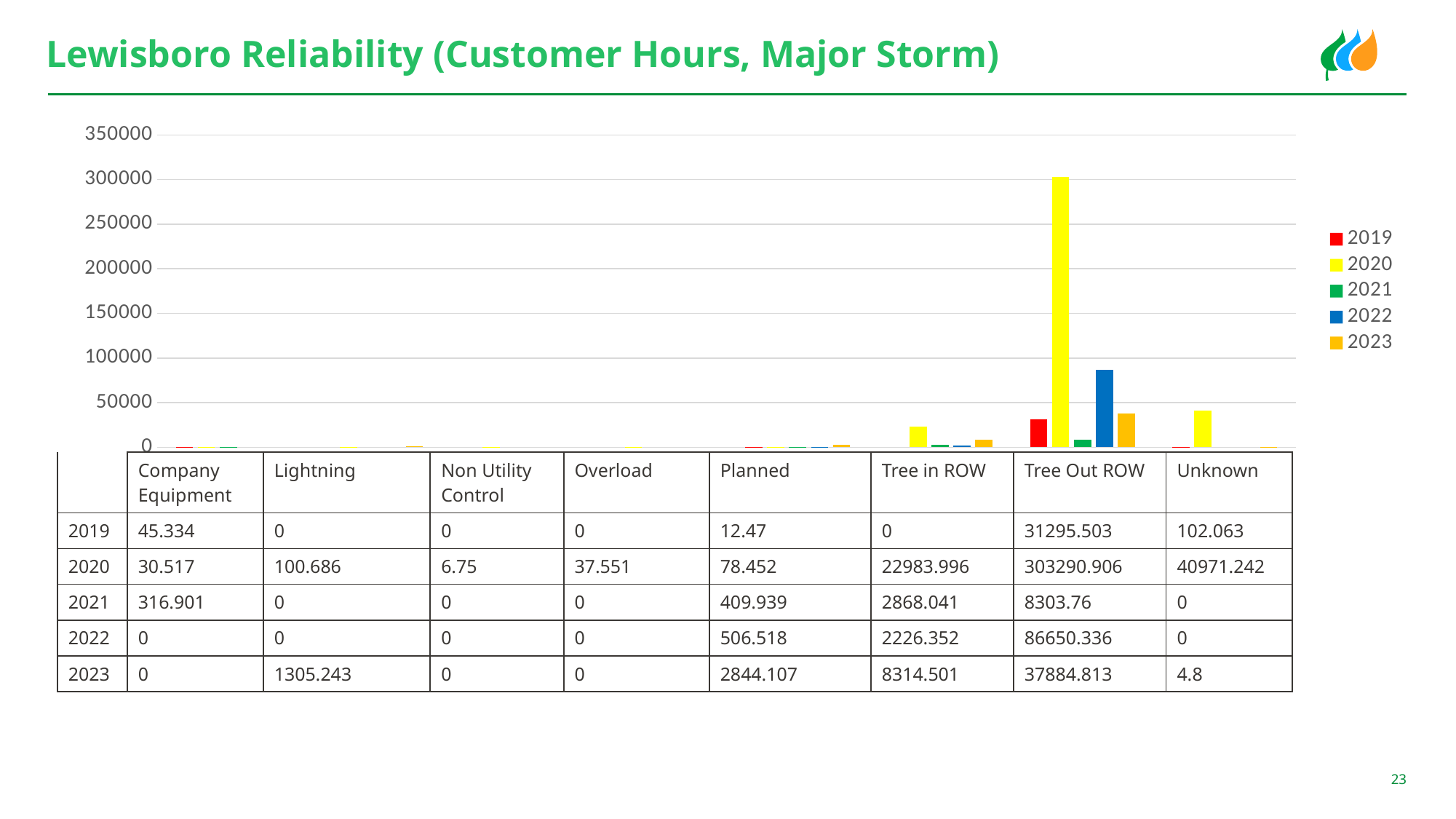
What is the difference between the Tree Out ROW values for 2022 and 2023? 48765.523 Which category has the highest value for 2020? Tree Out ROW Which year has the highest value for Tree Out ROW? 2020 What type of chart is shown on the slide? bar chart What colour represents the 2020 series in the chart? yellow Is the value for Tree Out ROW in 2022 greater or less than 100000? less Which is larger for 2020: Tree in ROW or Unknown? Unknown How many series does the legend list? 5 What is the value for Tree Out ROW in 2020? 303290.906 What is the value for Unknown in 2020? 40971.242 What is the value for Tree in ROW in 2023? 8314.501 How many outage cause categories are shown along the x axis? 8